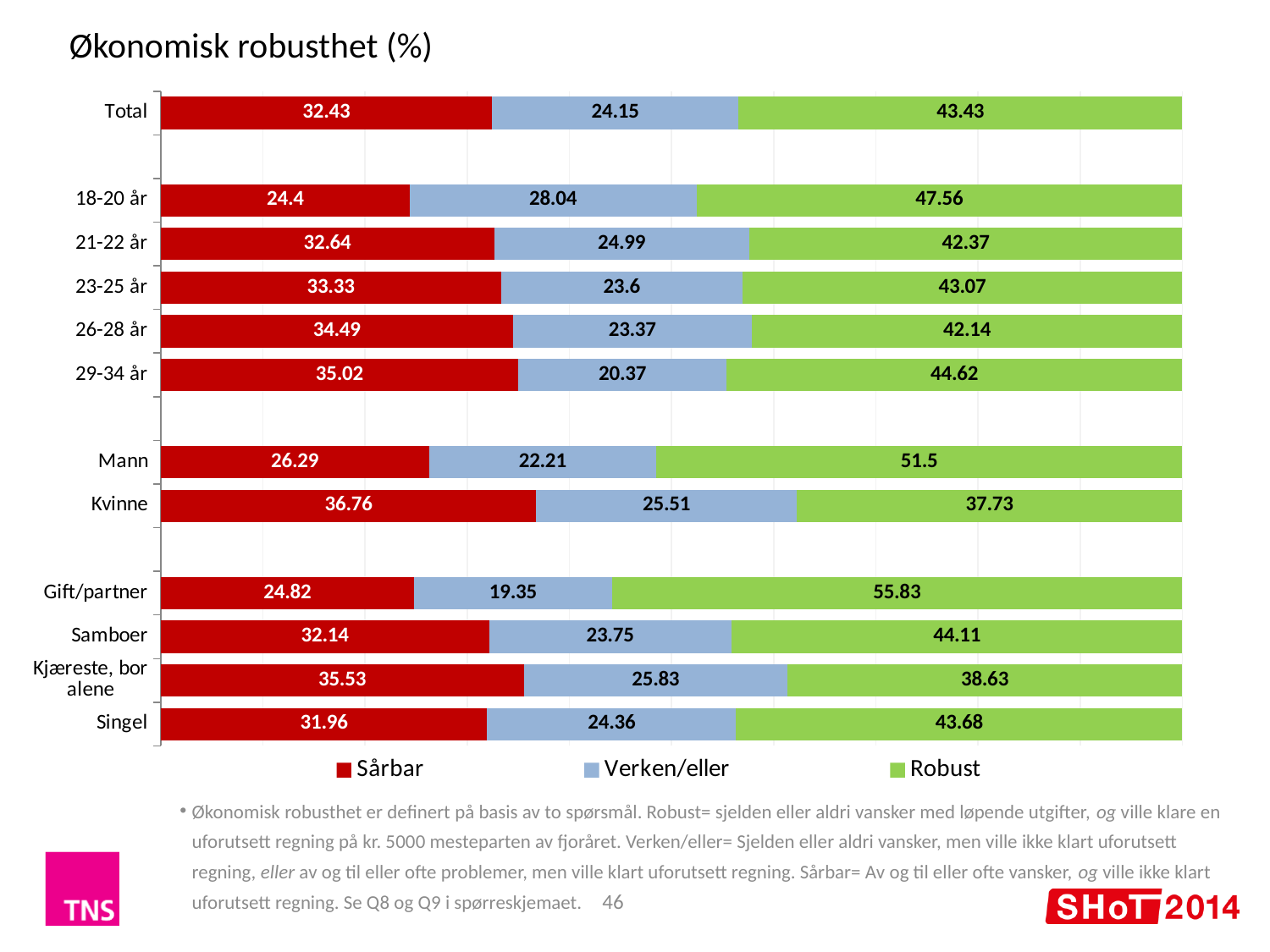
What is the Verken/eller value for 18-20 år? 28.04 How many categories are shown on the chart? 12 What is the Sårbar value for Kvinne? 36.76 Which category has the highest Robust value? Gift/partner What is the total of the stacked bar for Mann? 100 What is the Robust value for Gift/partner? 55.83 Which has the larger Robust value, 18-20 år or 29-34 år? 18-20 år Which category has the lowest Sårbar value? 18-20 år How many series does the legend list? 3 What kind of chart is shown on the slide? Stacked bar chart Do the Sårbar values rise or fall across the age groups from 18-20 år to 29-34 år? Rise What is the difference between the Robust values for Mann and Kvinne? 13.77